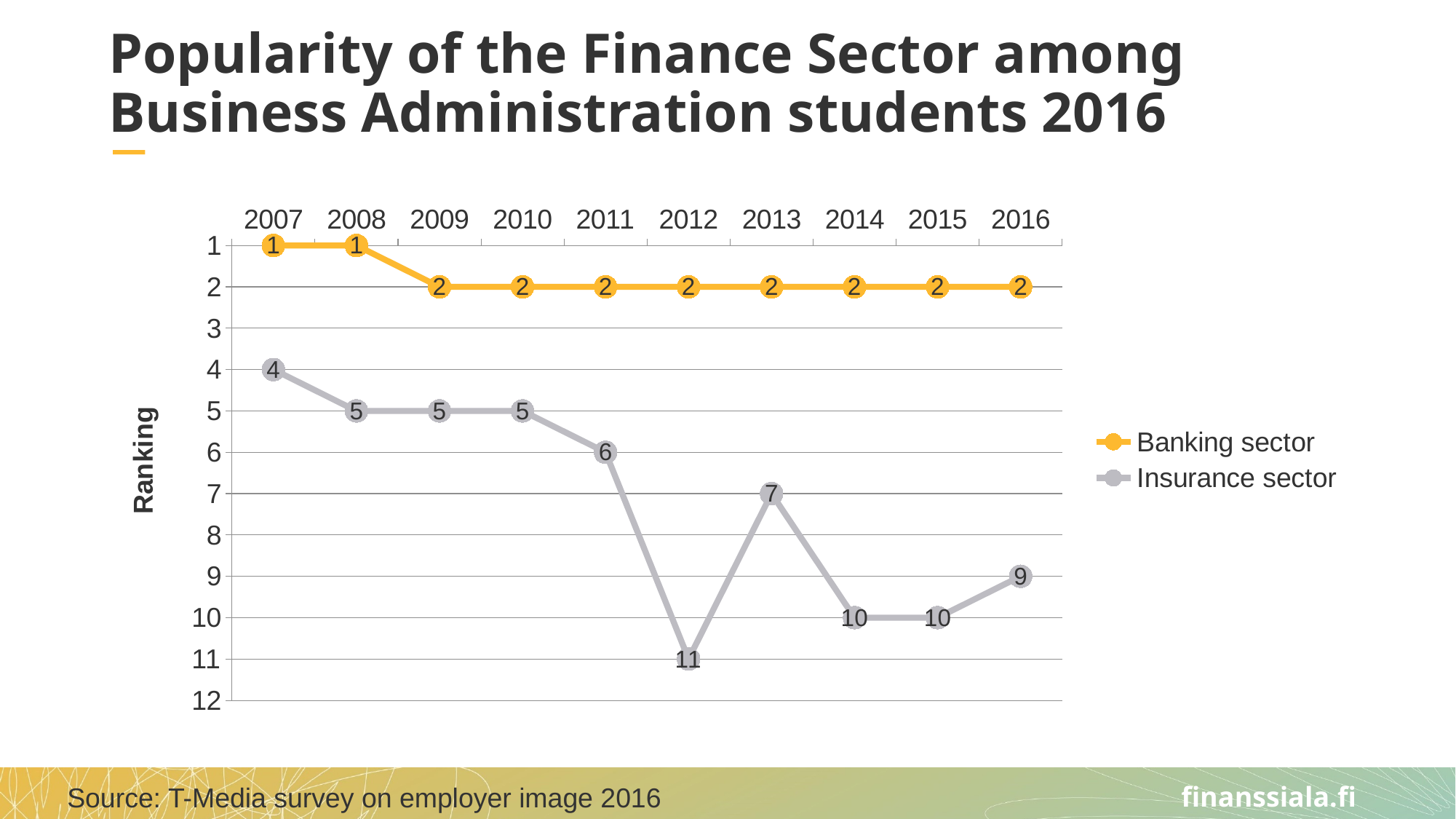
What is the Insurance sector's ranking in 2012? 11 Does the Insurance sector's ranking number rise or fall from 2007 to 2012? Rises What kind of chart is shown on the slide? Line chart What is the Banking sector's ranking in 2007? 1 What is the difference between the Insurance sector's and the Banking sector's ranking numbers in 2012? 9 What is the Banking sector's ranking in 2016? 2 In which year does the Insurance sector have its smallest ranking number? 2007 How many series does the legend list? 2 How many years are plotted on the x axis? 10 What is the Insurance sector's ranking in 2016? 9 Which year has the larger ranking number for the Insurance sector, 2013 or 2014? 2014 In which year does the Insurance sector have its largest ranking number? 2012